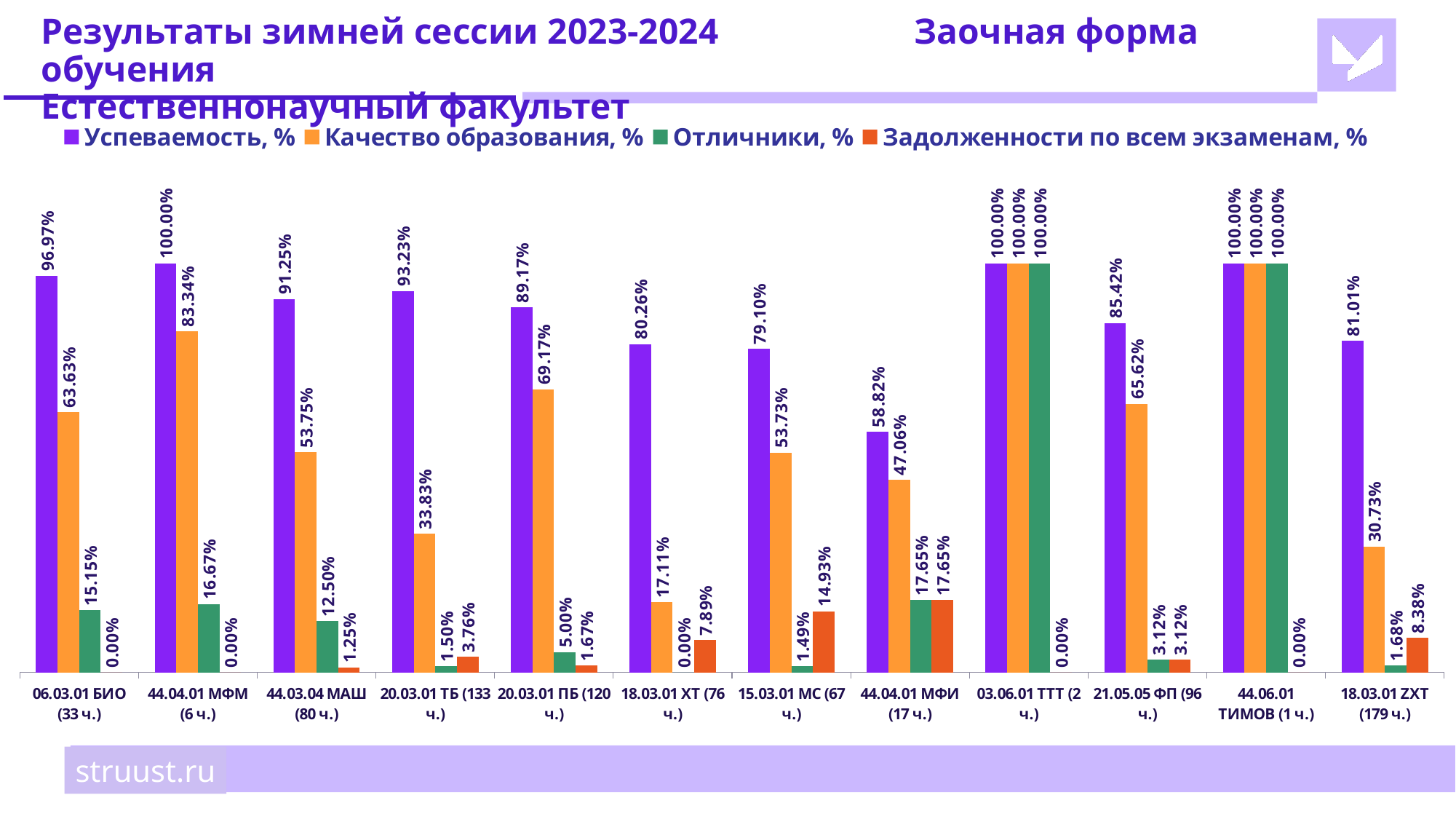
Which is larger: Качество образования, % for 44.03.04 МАШ (80 ч.) or for 18.03.01 ZХТ (179 ч.)? 44.03.04 МАШ (80 ч.) What is the value of Качество образования, % for 20.03.01 ПБ (120 ч.)? 69.17% What is the value of Успеваемость, % for 06.03.01 БИО (33 ч.)? 96.97% Which category has the lowest value of Успеваемость, %? 44.04.01 МФИ (17 ч.) How many series does the legend list? 4 What is the difference between Успеваемость, % and Качество образования, % for 20.03.01 ТБ (133 ч.)? 59.40% What kind of chart is shown on the slide? Bar chart Which series is shown in purple in the legend? Успеваемость, % What is the value of Задолженности по всем экзаменам, % for 18.03.01 ХТ (76 ч.)? 7.89% Which category has the highest value of Задолженности по всем экзаменам, %? 44.04.01 МФИ (17 ч.) What is the value of Отличники, % for 44.04.01 МФМ (6 ч.)? 16.67% How many categories are shown on the x axis? 12